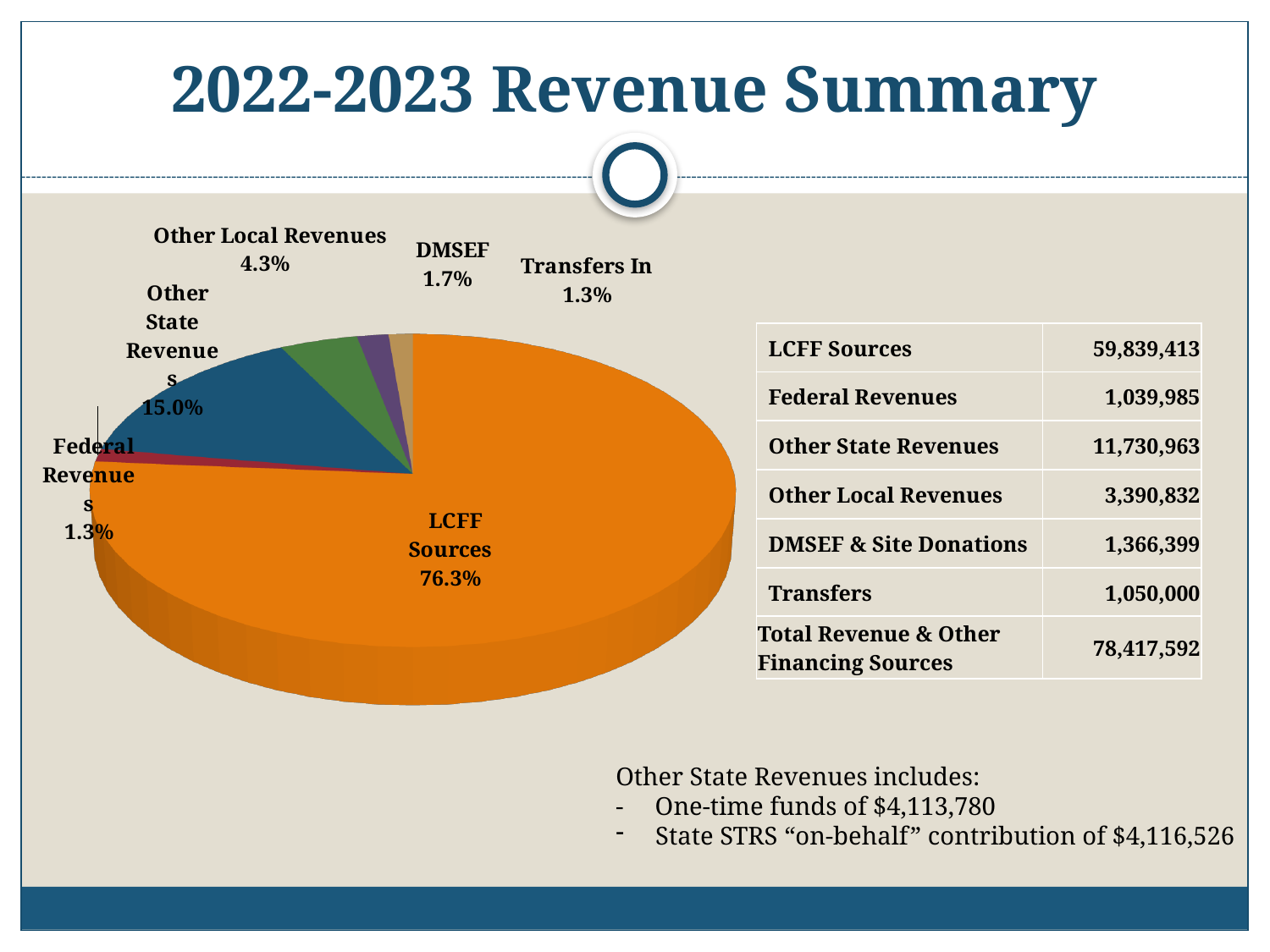
What is the difference in percentage points between LCFF Sources and Other State Revenues? 61.3% What percentage is shown for Federal Revenues? 1.3% What share of the pie does LCFF Sources represent? 76.3% What percentage is shown for Other Local Revenues? 4.3% Which is larger, Other State Revenues or Other Local Revenues? Other State Revenues How many slices does the pie chart have? 6 What percentage is shown for Transfers In? 1.3% What kind of chart is shown on the slide? Pie chart What percentage is shown for DMSEF? 1.7% What colour is the LCFF Sources slice? Orange Which slice of the pie is the largest? LCFF Sources What percentage is shown for Other State Revenues? 15.0%